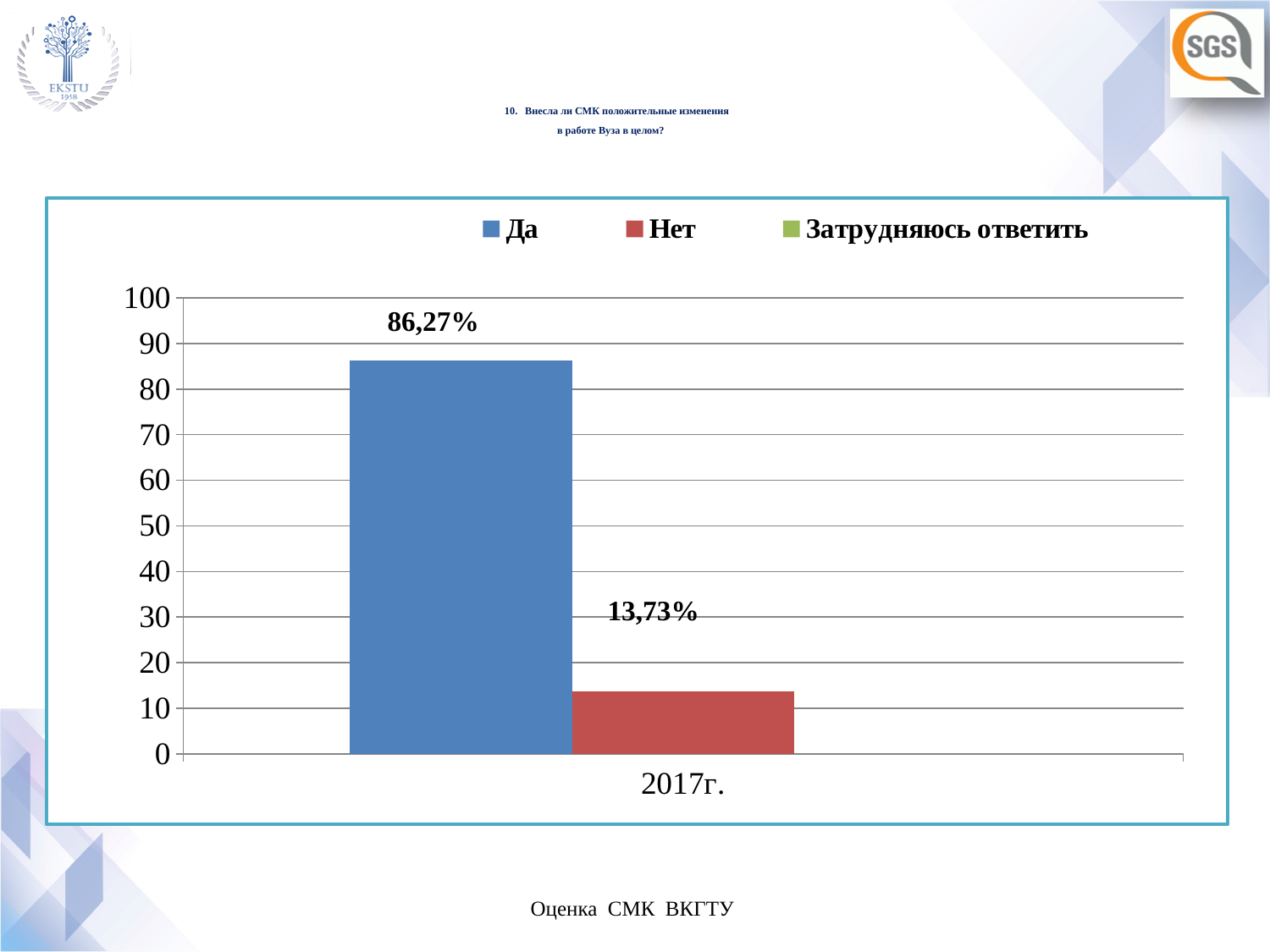
How many categories are shown on the x axis? 1 Is the value for "Нет" greater or less than 20? less Which is larger, the value for "Да" or the value for "Нет"? Да What is the value for "Нет" in 2017г.? 13,73% What is the difference between the values for "Да" and "Нет" in 2017г.? 72,54% Is the value for "Да" greater or less than 80? greater What colour is the bar for "Нет"? red How many series does the legend list? 3 Which series has the highest value in 2017г.? Да What kind of chart is shown on the slide? bar chart Which of the two plotted bars is lower, "Да" or "Нет"? Нет What is the value for "Да" in 2017г.? 86,27%